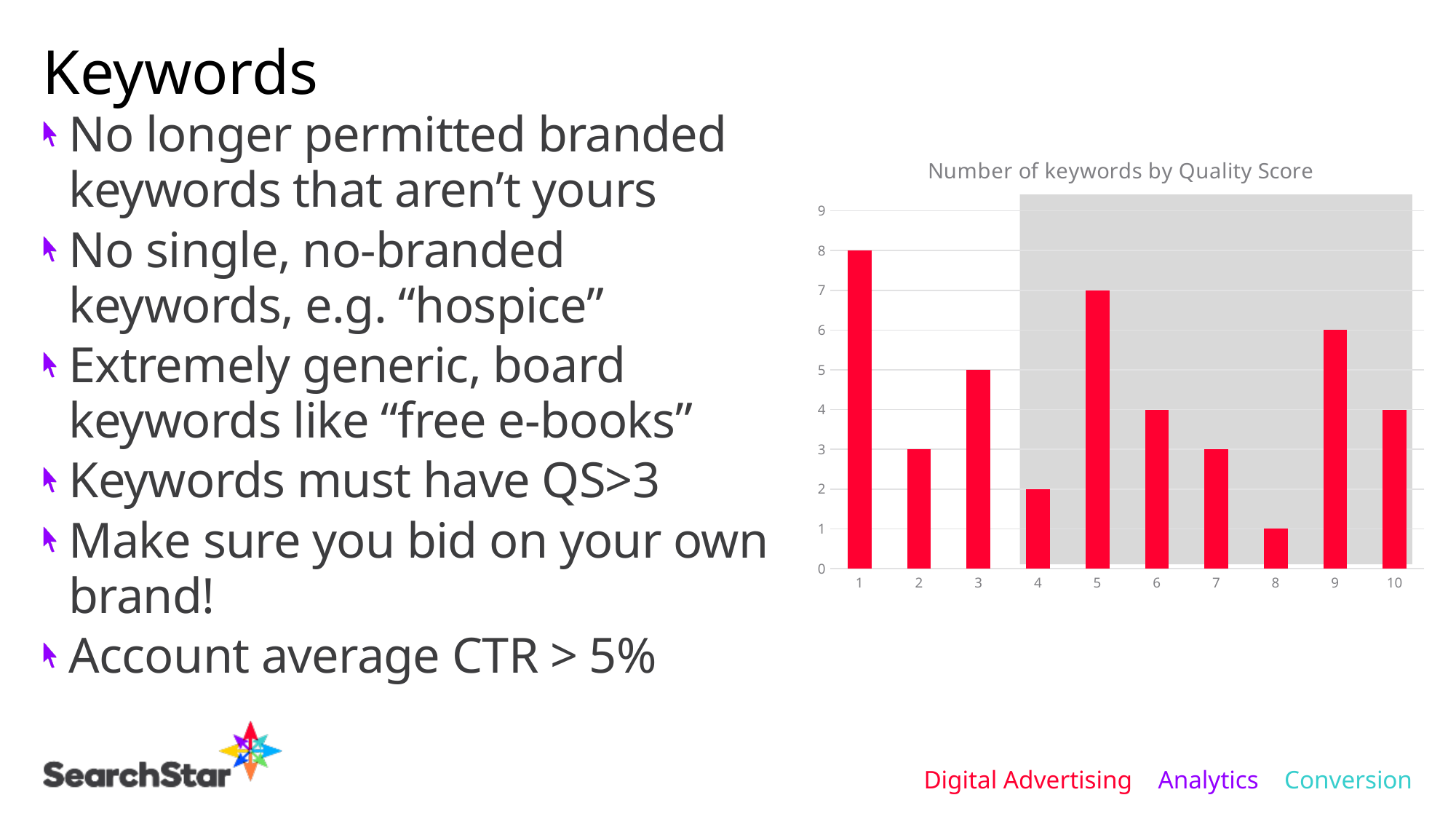
How many quality score categories are plotted on the x axis? 10 What is the difference between the number of keywords at Quality Score 1 and at Quality Score 9? 2 What is the number of keywords with a Quality Score of 8? 1 What is the title of the chart? Number of keywords by Quality Score Which Quality Score has the lowest number of keywords? 8 What is the number of keywords with a Quality Score of 5? 7 Is the number of keywords at Quality Score 9 greater or less than 5? greater Which has more keywords, Quality Score 3 or Quality Score 6? Quality Score 3 What kind of chart is shown on the slide? bar chart What is the number of keywords with a Quality Score of 1? 8 What colour are the bars in the chart? red Which Quality Score has the highest number of keywords? 1